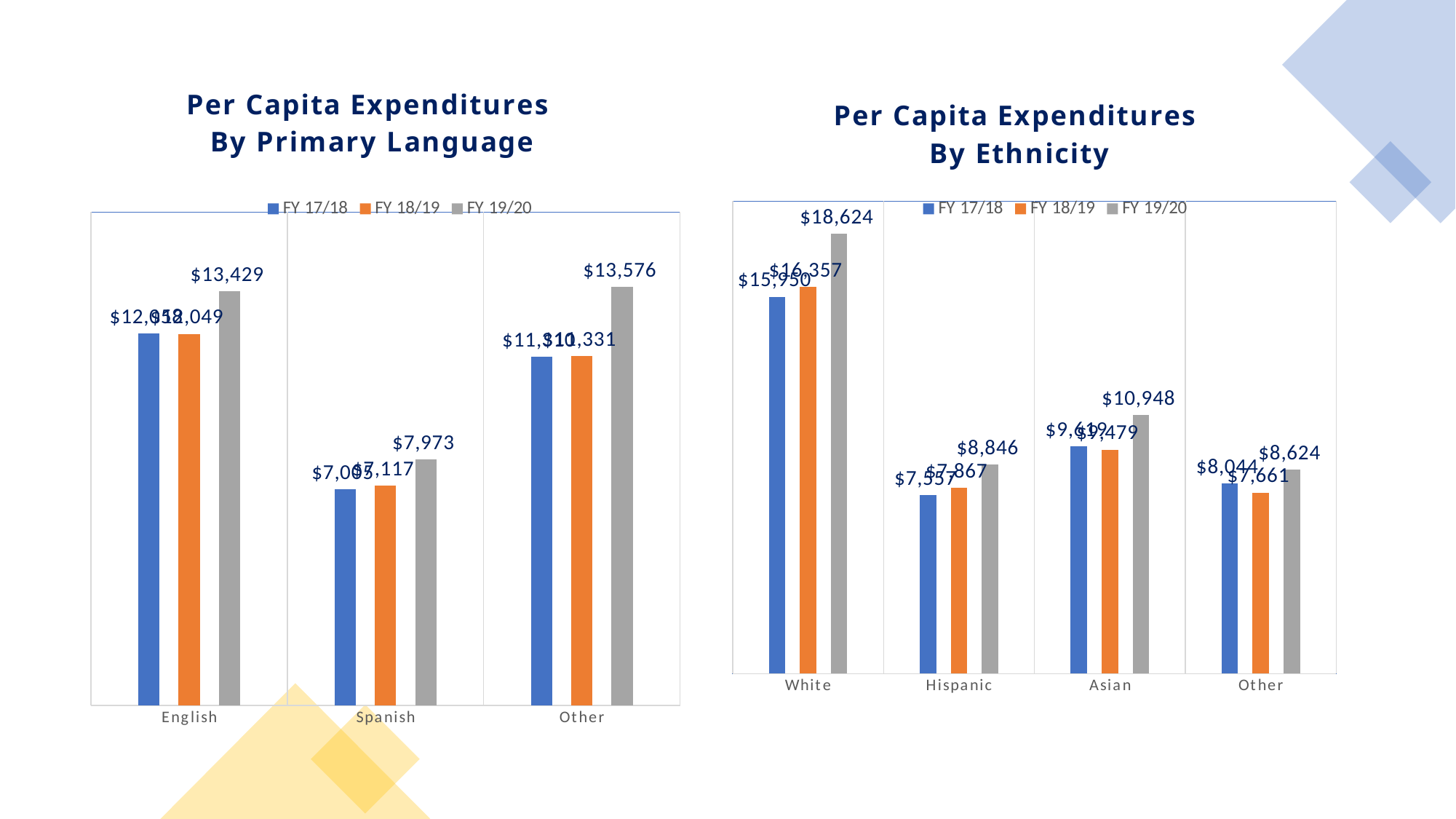
In the 'Per Capita Expenditures By Ethnicity' chart, which ethnicity has the highest FY 19/20 value? White In the 'Per Capita Expenditures By Primary Language' chart, what is the difference between the FY 19/20 values for Other and Spanish? $5,603 In the 'Per Capita Expenditures By Ethnicity' chart, what is the difference between the FY 19/20 values for White and Hispanic? $9,778 In the 'Per Capita Expenditures By Ethnicity' chart, what is the FY 19/20 value for Asian? $10,948 In the 'Per Capita Expenditures By Ethnicity' chart, how many series does the legend list? 3 What kind of chart is the 'Per Capita Expenditures By Primary Language' chart? Bar chart In the 'Per Capita Expenditures By Primary Language' chart, what is the FY 19/20 value for English? $13,429 In the 'Per Capita Expenditures By Ethnicity' chart, what is the FY 18/19 value for Hispanic? $7,867 In the 'Per Capita Expenditures By Ethnicity' chart, what is the FY 19/20 value for White? $18,624 In the 'Per Capita Expenditures By Primary Language' chart, what is the FY 19/20 value for Spanish? $7,973 In the 'Per Capita Expenditures By Ethnicity' chart, how many ethnicity categories are shown on the x axis? 4 In the 'Per Capita Expenditures By Primary Language' chart, what is the FY 19/20 value for Other? $13,576